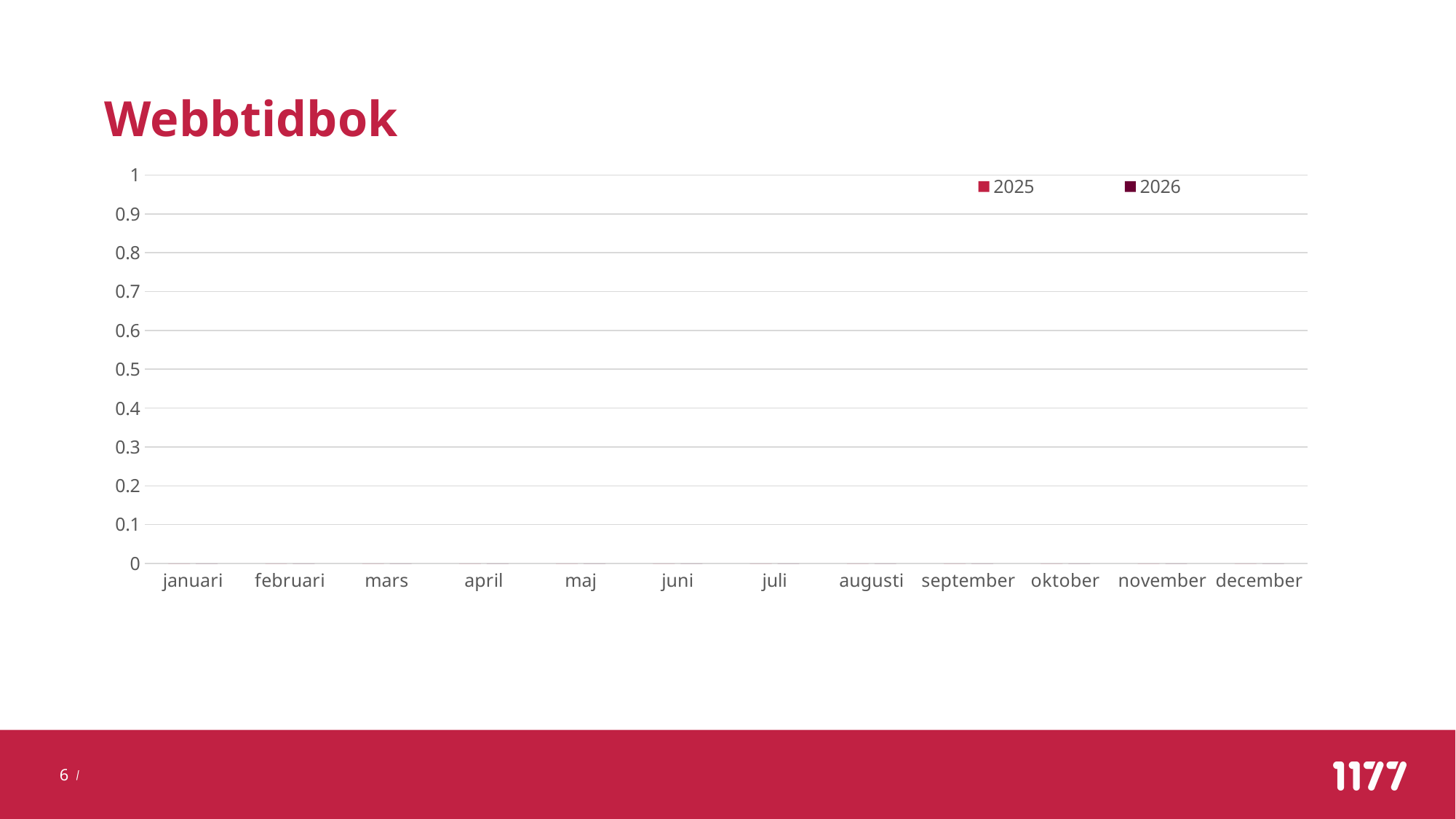
How many categories are shown along the x axis of the chart? 12 What is the title of the slide containing the chart? Webbtidbok What are the two series named in the chart legend? 2025 and 2026 What is the first category on the x axis of the chart? januari What is the last category on the x axis of the chart? december How many series does the chart legend list? 2